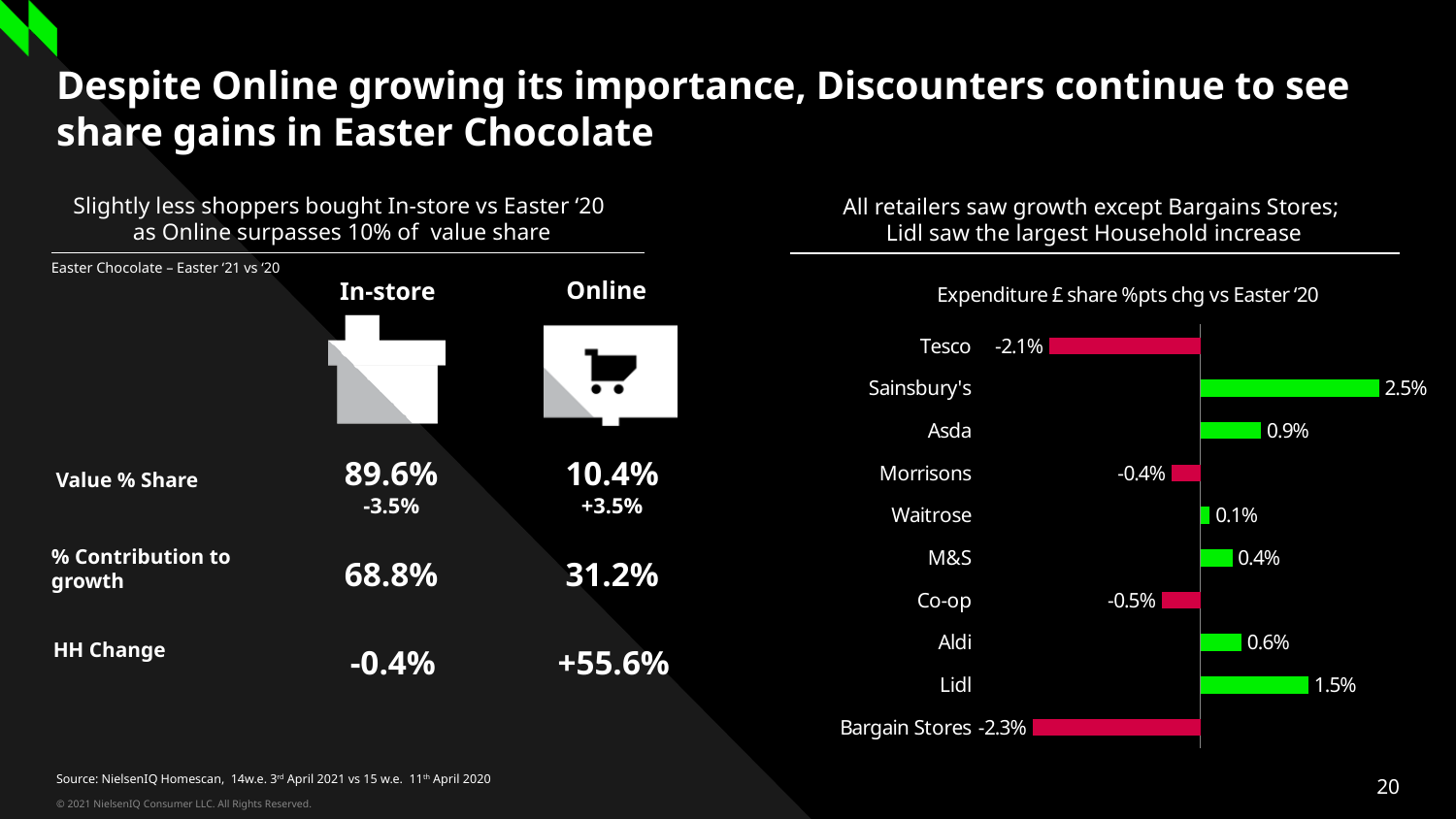
Which retailer has the highest expenditure £ share %pts change vs Easter '20? Sainsbury's What is the difference between the share %pts change for Sainsbury's and Lidl? 1.0% What colour are the bars for retailers with negative share %pts change? Red What is the expenditure £ share %pts change for Sainsbury's? 2.5% What kind of chart is used to show the expenditure £ share %pts change vs Easter '20? Bar chart Which retailer has the lowest expenditure £ share %pts change vs Easter '20? Bargain Stores What is the title of the chart on the right side of the slide? Expenditure £ share %pts chg vs Easter '20 Which has a larger share %pts change, Asda or Aldi? Asda What is the expenditure £ share %pts change for Tesco? -2.1% What is the expenditure £ share %pts change for Bargain Stores? -2.3% What is the expenditure £ share %pts change for Lidl? 1.5% How many retailers are shown in the expenditure £ share %pts change chart? 10